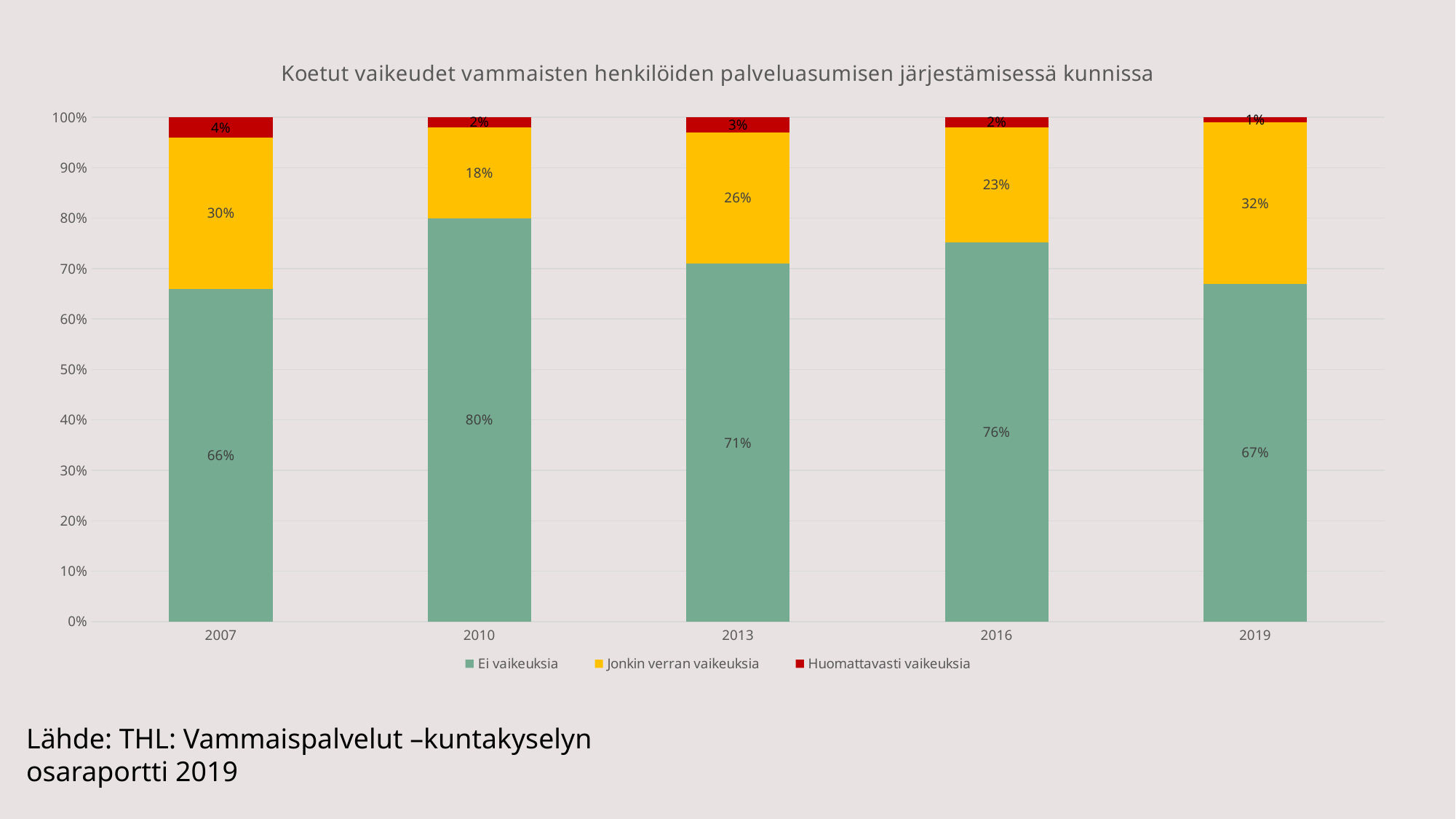
What kind of chart is shown on the slide? Stacked bar chart What is the difference between the Ei vaikeuksia values for 2010 and 2007? 14% How many years are shown on the x axis? 5 What is the title of the chart? Koetut vaikeudet vammaisten henkilöiden palveluasumisen järjestämisessä kunnissa How many series does the legend list? 3 In which year is the Ei vaikeuksia share highest? 2010 What is the value for Jonkin verran vaikeuksia in 2019? 32% Which is larger, the Jonkin verran vaikeuksia value for 2013 or for 2016? 2013 In which year is the Huomattavasti vaikeuksia share lowest? 2019 What is the value for Huomattavasti vaikeuksia in 2007? 4% Which series is shown in red? Huomattavasti vaikeuksia What is the value for Ei vaikeuksia in 2010? 80%